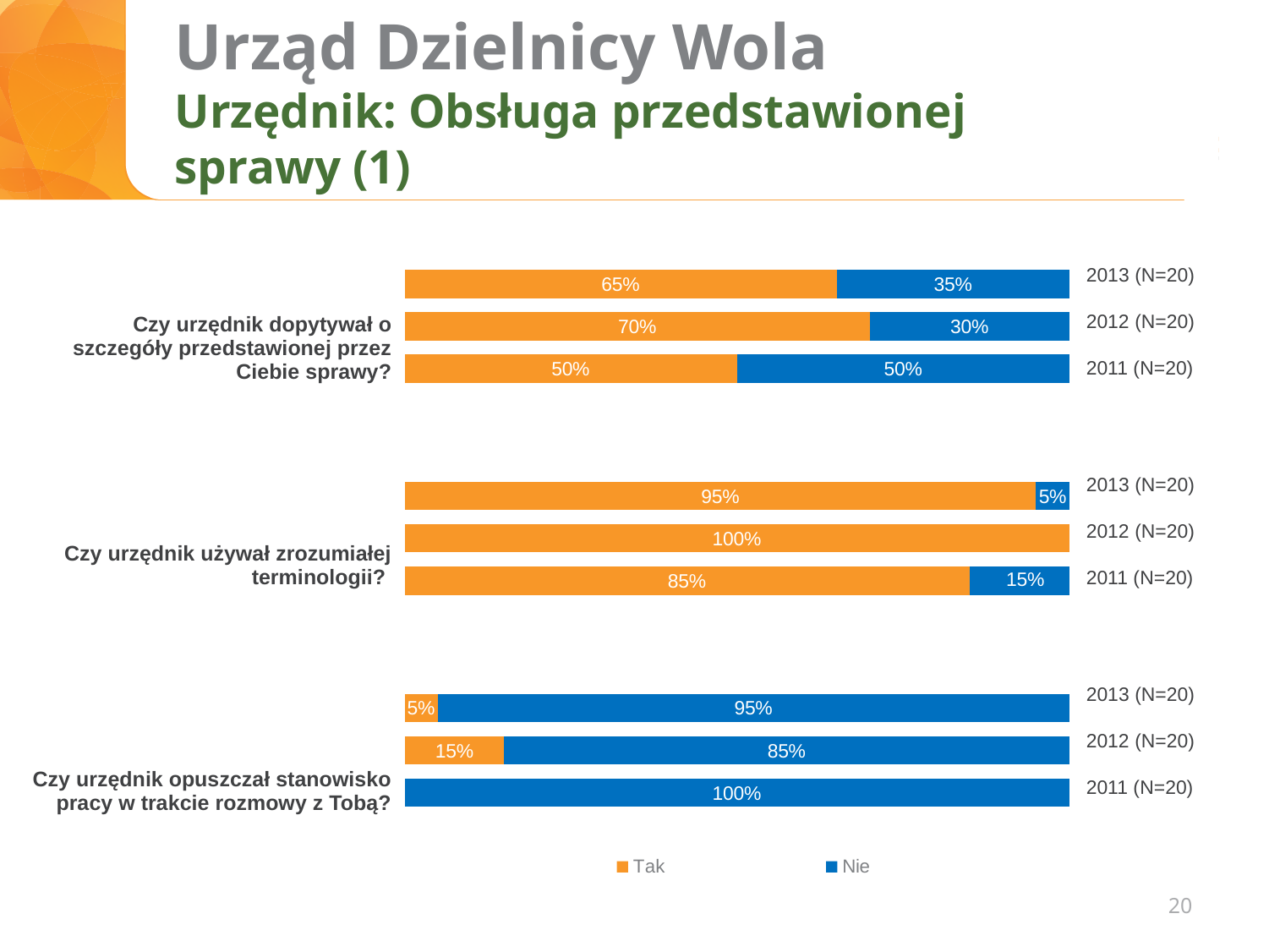
In the chart for "Czy urzędnik używał zrozumiałej terminologii?", which year has the lowest Tak value? 2011 (N=20) In the chart for "Czy urzędnik opuszczał stanowisko pracy w trakcie rozmowy z Tobą?", which is larger: the Tak value for 2012 (N=20) or the Tak value for 2013 (N=20)? 2012 (N=20) In the chart for "Czy urzędnik dopytywał o szczegóły przedstawionej przez Ciebie sprawy?", what is the Nie value for 2012 (N=20)? 30% In the chart for "Czy urzędnik używał zrozumiałej terminologii?", what is the total of the 2013 (N=20) stacked bar? 100% In the chart for "Czy urzędnik dopytywał o szczegóły przedstawionej przez Ciebie sprawy?", what is the Tak value for 2013 (N=20)? 65% In the chart for "Czy urzędnik dopytywał o szczegóły przedstawionej przez Ciebie sprawy?", what is the difference between the Tak values for 2012 (N=20) and 2011 (N=20)? 20% Which colour represents Nie in the legend? Blue What kind of chart is shown on the slide? Stacked bar chart In the chart for "Czy urzędnik opuszczał stanowisko pracy w trakcie rozmowy z Tobą?", what is the Nie value for 2013 (N=20)? 95% How many series does the legend list? 2 In the chart for "Czy urzędnik dopytywał o szczegóły przedstawionej przez Ciebie sprawy?", which year has the highest Tak value? 2012 (N=20) In the chart for "Czy urzędnik używał zrozumiałej terminologii?", what is the Tak value for 2011 (N=20)? 85%